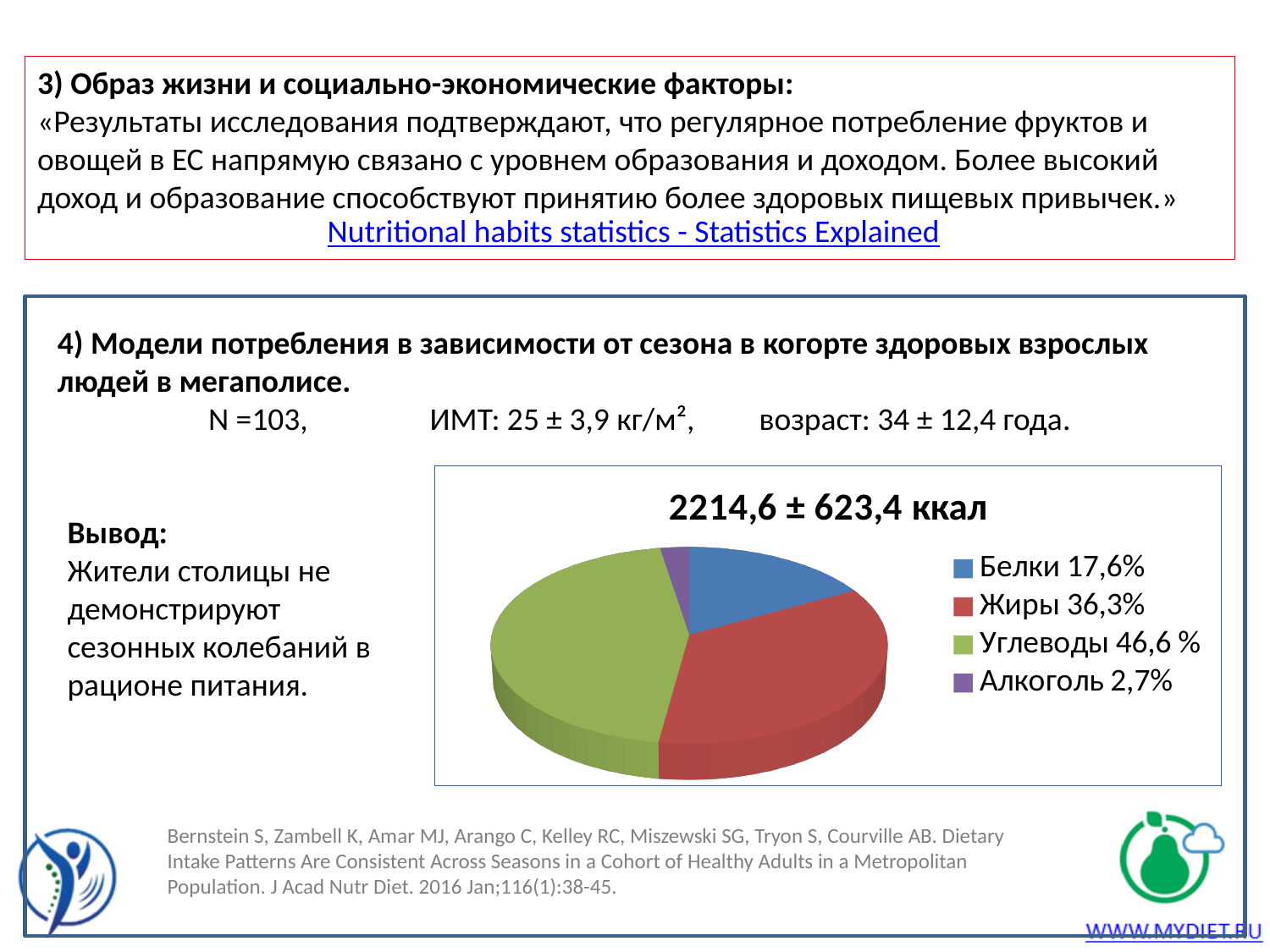
What share of the pie does Жиры have? 36,3% How many categories does the pie chart show? 4 What share of the pie does Углеводы have? 46,6 % What share of the pie does Белки have? 17,6% What share of the pie does Алкоголь have? 2,7% Which is larger, the share for Жиры or the share for Белки? Жиры What is the difference in percentage points between the shares of Жиры and Белки? 18,7 Which category has the largest slice of the pie? Углеводы What is the title of the pie chart? 2214,6 ± 623,4 ккал Which category has the smallest slice of the pie? Алкоголь What colour is the Углеводы slice in the pie chart? Green What type of chart is shown on the slide? Pie chart